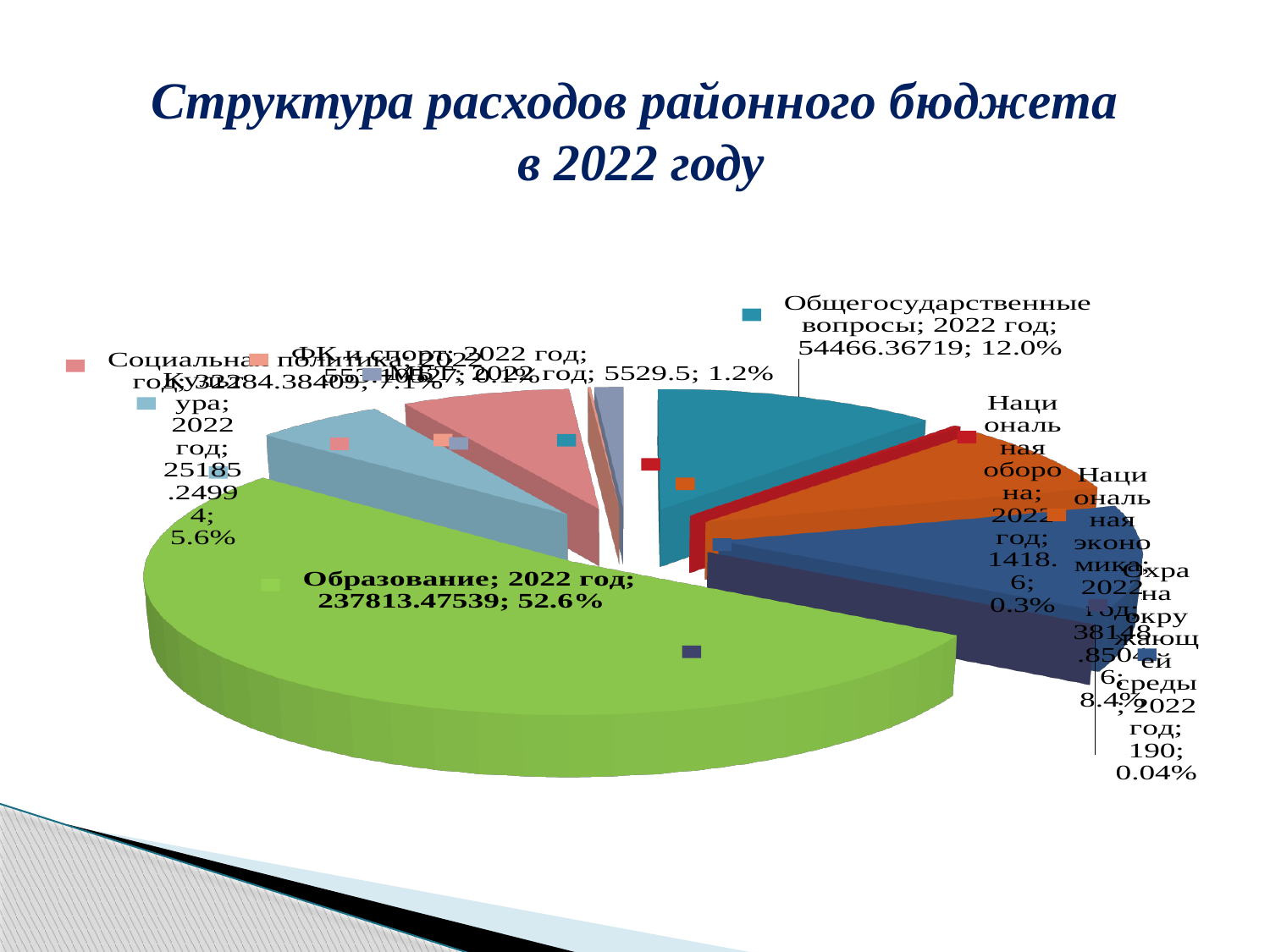
What kind of chart is shown on the slide? Pie chart What is the value shown for Национальная оборона? 1418.6 Which category has the largest slice of the pie? Образование What is the title of the chart on the slide? Структура расходов районного бюджета в 2022 году Which category has the smallest slice of the pie? Охрана окружающей среды What share of the pie does Общегосударственные вопросы account for? 12.0% What share of the pie does Охрана окружающей среды account for? 0.04% What is the value shown for Образование? 237813.47539 What share of the pie does Образование account for? 52.6% Which has a larger share: Общегосударственные вопросы or Национальная экономика? Общегосударственные вопросы What is the difference in percentage share between Образование and Общегосударственные вопросы? 40.6% What is the value shown for Общегосударственные вопросы? 54466.36719